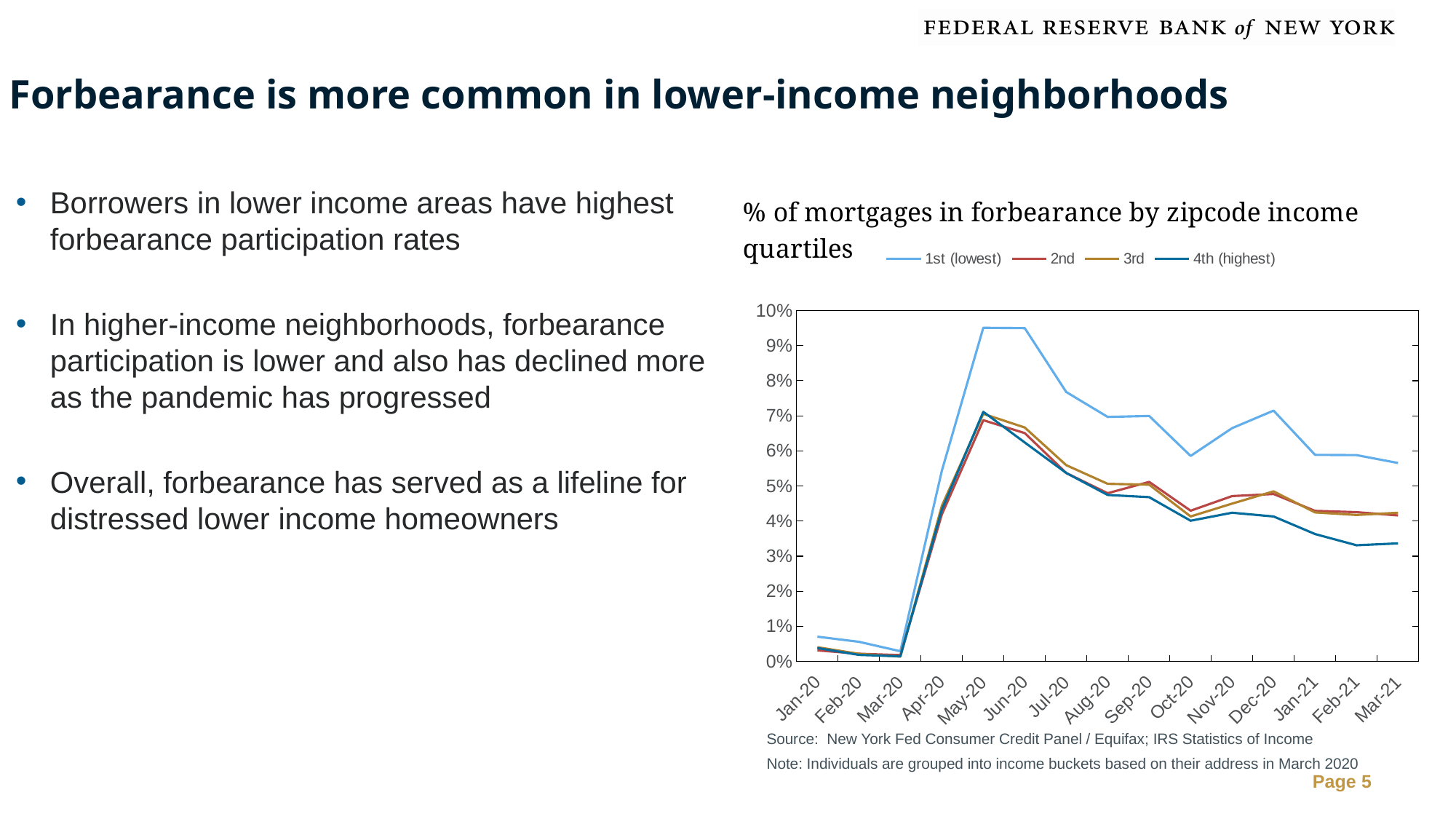
Is the value for the 2nd quartile in Oct-20 greater or less than 5%? less What kind of chart is shown on the slide? line chart How many months are shown along the x axis of the chart? 15 Is the value for the 1st (lowest) quartile in May-20 greater or less than 9%? greater Does the 4th (highest) quartile series rise or fall from Jun-20 to Mar-21? fall Is the value for the 4th (highest) quartile in Mar-21 greater or less than 4%? less Which series has the highest value in Mar-21? 1st (lowest) In Dec-20, which is larger: the value for the 1st (lowest) quartile or the 4th (highest) quartile? 1st (lowest) How many series does the chart's legend list? 4 What are the four series listed in the chart's legend? 1st (lowest), 2nd, 3rd, 4th (highest) Which series has the lowest value in Mar-21? 4th (highest) What is the title of the chart? % of mortgages in forbearance by zipcode income quartiles